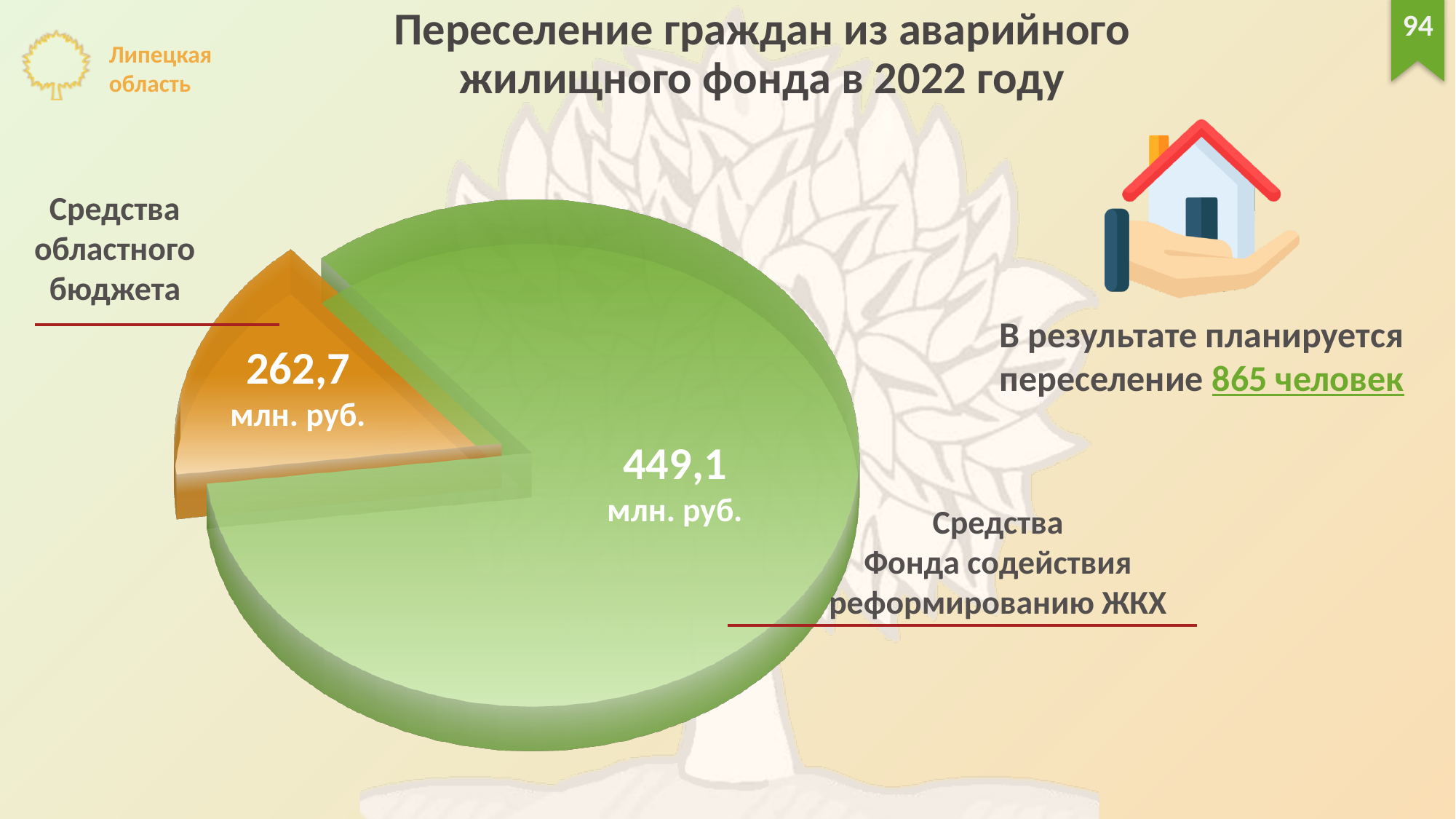
What is the value of the slice labelled «Средства Фонда содействия реформированию ЖКХ»? 449,1 млн. руб. Which slice of the pie chart is the smallest? Средства областного бюджета Which is larger: the funds from the regional budget (областной бюджет) or the funds from the Фонд содействия реформированию ЖКХ? Средства Фонда содействия реформированию ЖКХ What is the title of the slide containing the pie chart? Переселение граждан из аварийного жилищного фонда в 2022 году What is the total of the two slices in the pie chart, in млн. руб.? 711,8 млн. руб. What is the value of the slice labelled «Средства областного бюджета»? 262,7 млн. руб. How many slices does the pie chart have? 2 What kind of chart is shown on the slide? pie chart Which slice of the pie chart is the largest? Средства Фонда содействия реформированию ЖКХ What colour is the slice for «Средства областного бюджета»? orange What is the difference between the Фонд содействия реформированию ЖКХ funds and the regional budget funds, in млн. руб.? 186,4 млн. руб.